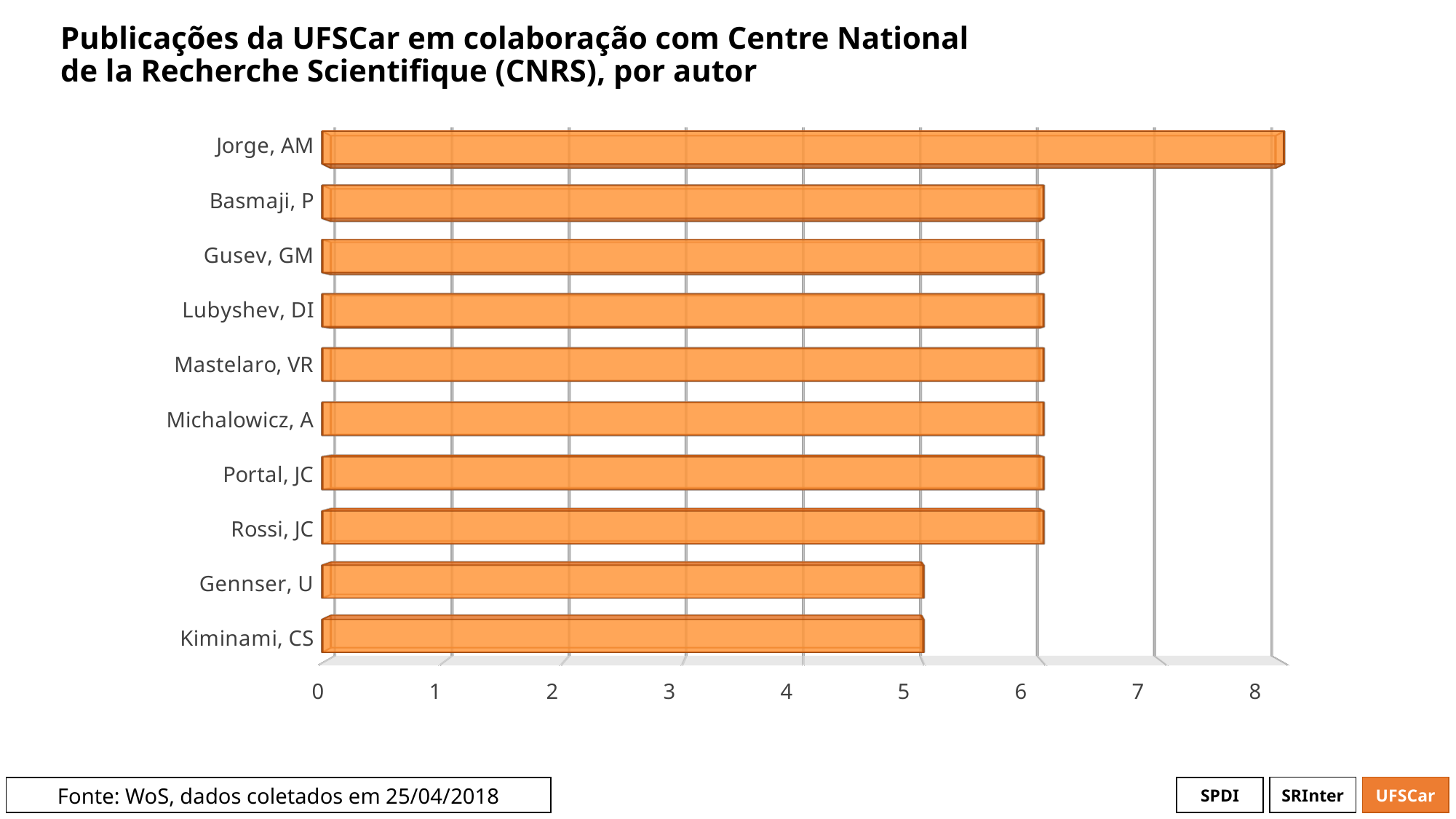
What is the source of the data cited on the slide? WoS, dados coletados em 25/04/2018 What kind of chart is shown on the slide? bar chart How many publications does Jorge, AM have according to the chart? 8 How many authors are shown in the chart? 10 What is the difference between the values for Jorge, AM and Gennser, U? 3 Which author is listed at the top of the chart? Jorge, AM Is the value for Kiminami, CS greater or less than 6? less How many publications does Basmaji, P have according to the chart? 6 Is the value for Jorge, AM greater or less than 7? greater How many publications does Kiminami, CS have according to the chart? 5 Which author has the highest number of publications in the chart? Jorge, AM Which is larger, the value for Rossi, JC or the value for Gennser, U? Rossi, JC